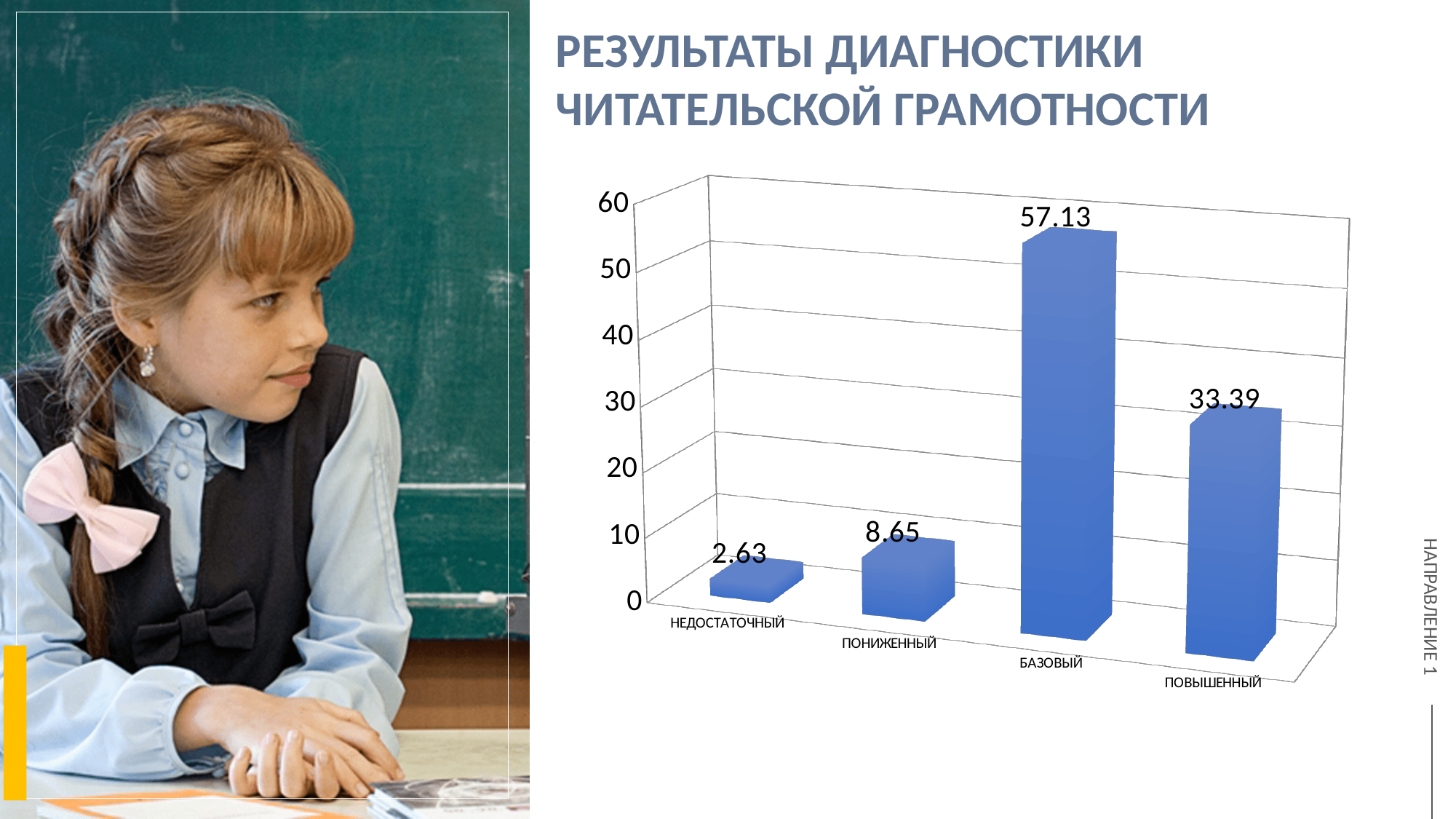
How many categories are shown in the chart? 4 What kind of chart is shown on the slide? bar chart What is the difference between the values for ПОНИЖЕННЫЙ and НЕДОСТАТОЧНЫЙ? 6.02 Which category has the lowest value? НЕДОСТАТОЧНЫЙ What is the title of the slide containing the chart? РЕЗУЛЬТАТЫ ДИАГНОСТИКИ ЧИТАТЕЛЬСКОЙ ГРАМОТНОСТИ What is the value for ПОВЫШЕННЫЙ? 33.39 Which is larger, the value for ПОВЫШЕННЫЙ or the value for ПОНИЖЕННЫЙ? ПОВЫШЕННЫЙ What is the value for БАЗОВЫЙ? 57.13 What is the value for НЕДОСТАТОЧНЫЙ? 2.63 What is the difference between the values for БАЗОВЫЙ and ПОВЫШЕННЫЙ? 23.74 Which category has the highest value? БАЗОВЫЙ What is the value for ПОНИЖЕННЫЙ? 8.65